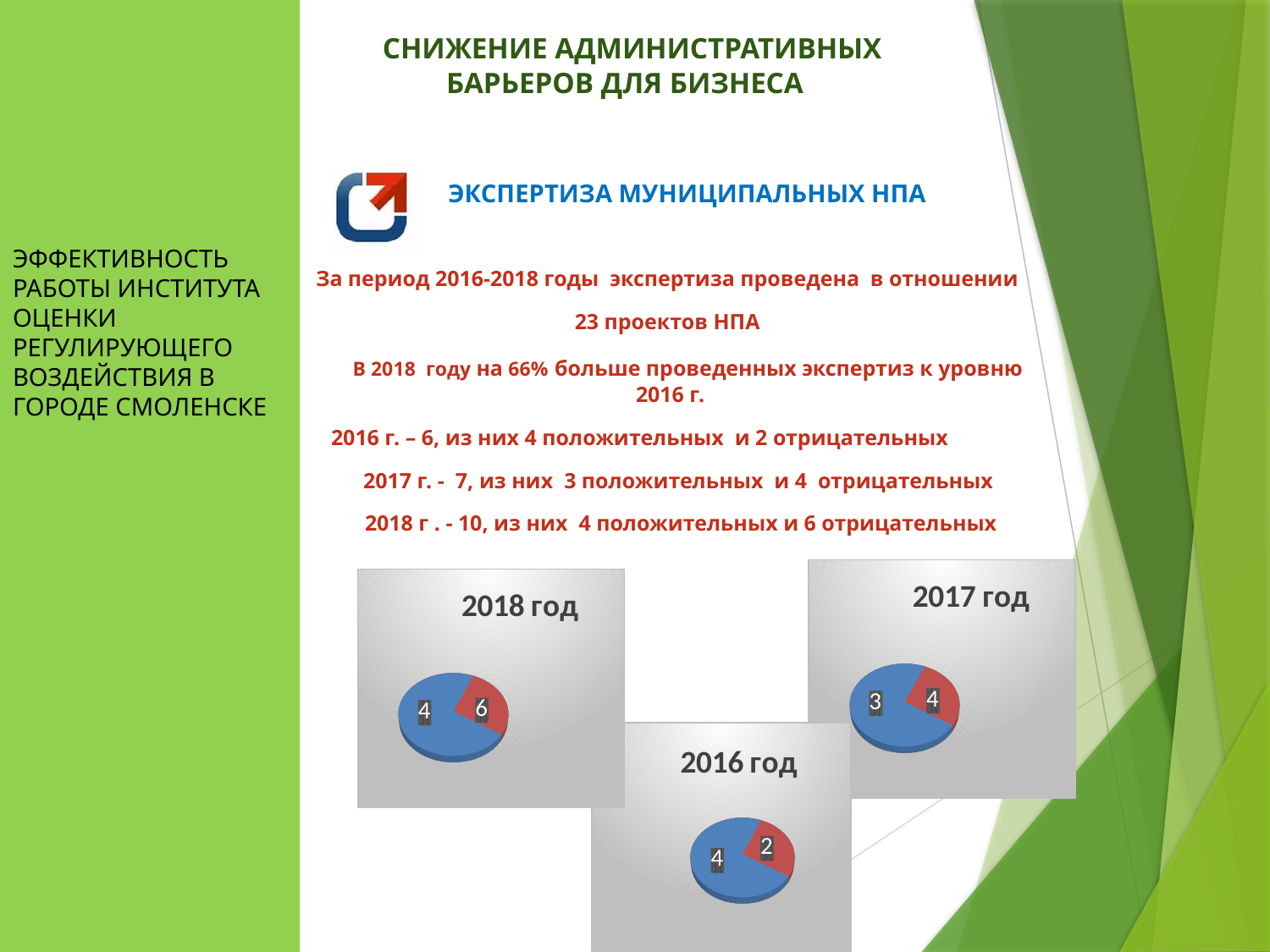
In the "2017 год" pie chart, what value is shown on the red slice? 4 In the "2018 год" pie chart, what is the difference between the red slice value and the blue slice value? 2 In the "2017 год" pie chart, what value is shown on the blue slice? 3 What is the total of the two slices in the "2016 год" pie chart? 6 In the "2016 год" pie chart, which slice is larger, the blue one or the red one? the blue one How many pie charts are shown on the slide? 3 In the "2018 год" pie chart, what value is shown on the blue slice? 4 In the "2018 год" pie chart, what value is shown on the red slice? 6 How many slices does the "2017 год" pie chart have? 2 What kind of chart is the "2018 год" chart? pie chart In the "2016 год" pie chart, what value is shown on the red slice? 2